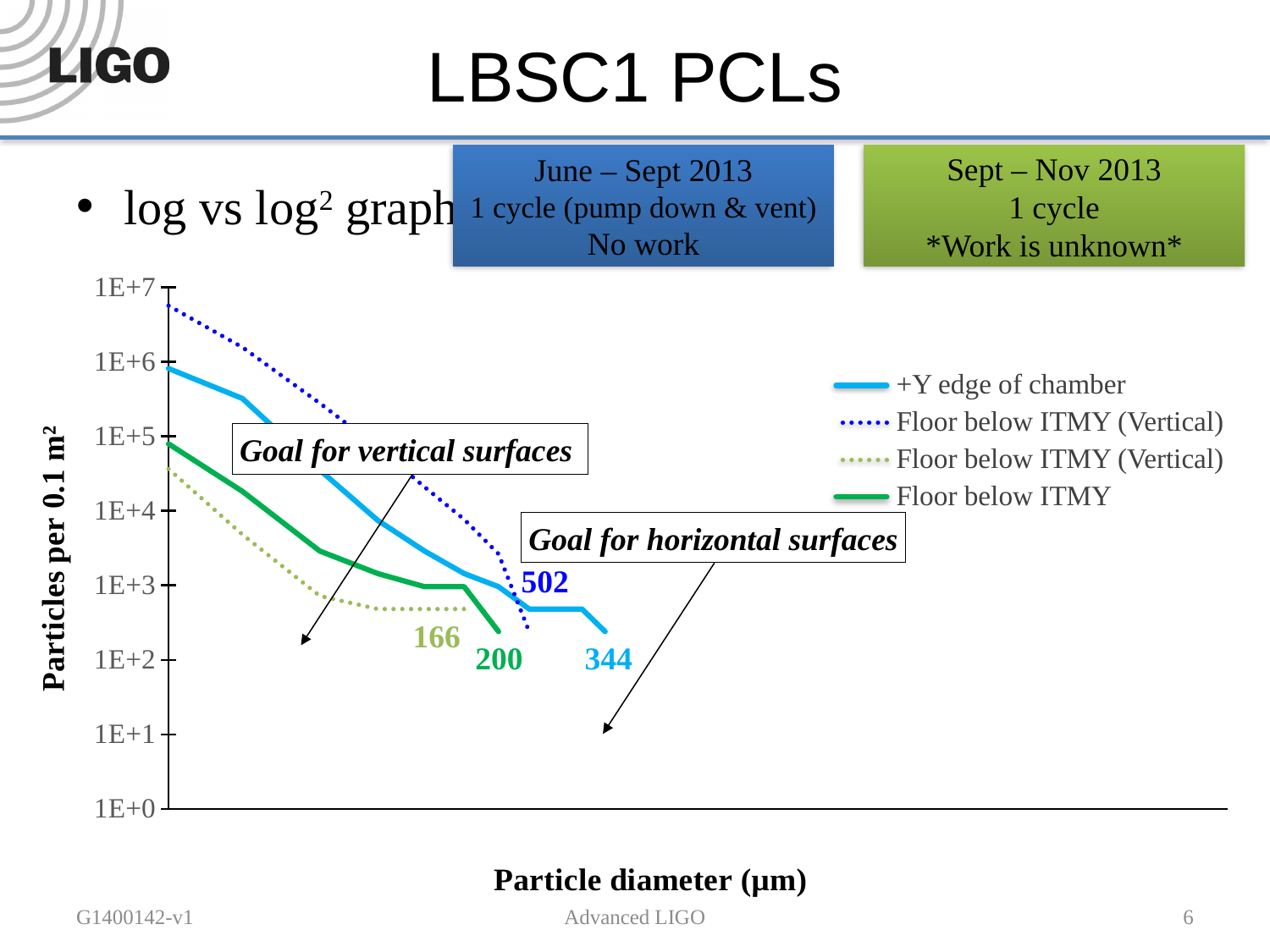
Is the leftmost value of the solid green Floor below ITMY line greater or less than 1E+6? less What number is printed at the end of the solid green Floor below ITMY line? 200 What is the title of the chart's horizontal axis? Particle diameter (µm) What number is printed in blue at the end of the blue dotted Floor below ITMY (Vertical) line? 502 Which line reaches the highest value at the left edge of the chart? the blue dotted Floor below ITMY (Vertical) line What is the title of the chart's vertical axis? Particles per 0.1 m² Do the plotted lines rise or fall as particle diameter increases along the x axis? fall How many series does the chart legend list? 4 What number is printed at the end of the +Y edge of chamber line? 344 What kind of chart is shown on the slide? line chart What number is printed at the end of the light green dotted Floor below ITMY (Vertical) line? 166 Is the leftmost value of the +Y edge of chamber line greater or less than 1E+5? greater